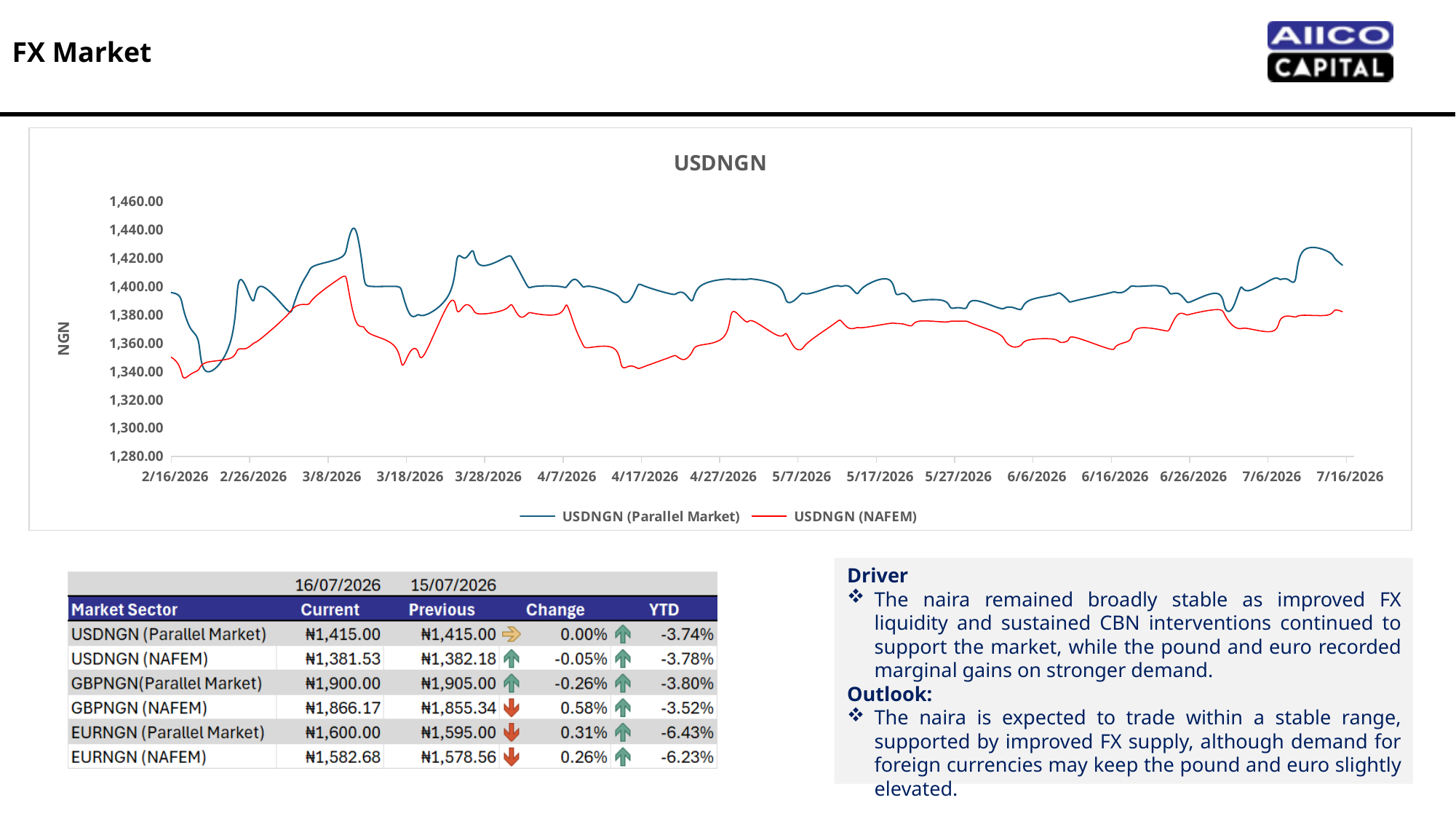
On the USDNGN chart, is the USDNGN (NAFEM) value at 4/17/2026 greater or less than 1,360? less What is the label on the vertical axis of the USDNGN chart? NGN On the USDNGN chart, which series is higher at 7/16/2026, USDNGN (Parallel Market) or USDNGN (NAFEM)? USDNGN (Parallel Market) What kind of chart is the USDNGN chart? line chart On the USDNGN chart, does the USDNGN (NAFEM) line rise or fall between 2/16/2026 and 3/8/2026? rise On the USDNGN chart, is the USDNGN (Parallel Market) value at 3/8/2026 greater or less than 1,400? greater How many series does the legend of the USDNGN chart list? 2 What are the two series named in the legend of the USDNGN chart? USDNGN (Parallel Market) and USDNGN (NAFEM) On the USDNGN chart, which series is higher at 2/16/2026, USDNGN (Parallel Market) or USDNGN (NAFEM)? USDNGN (Parallel Market) How many date labels are shown on the x axis of the USDNGN chart? 16 On the USDNGN chart, is the USDNGN (NAFEM) value at 2/16/2026 greater or less than 1,360? less